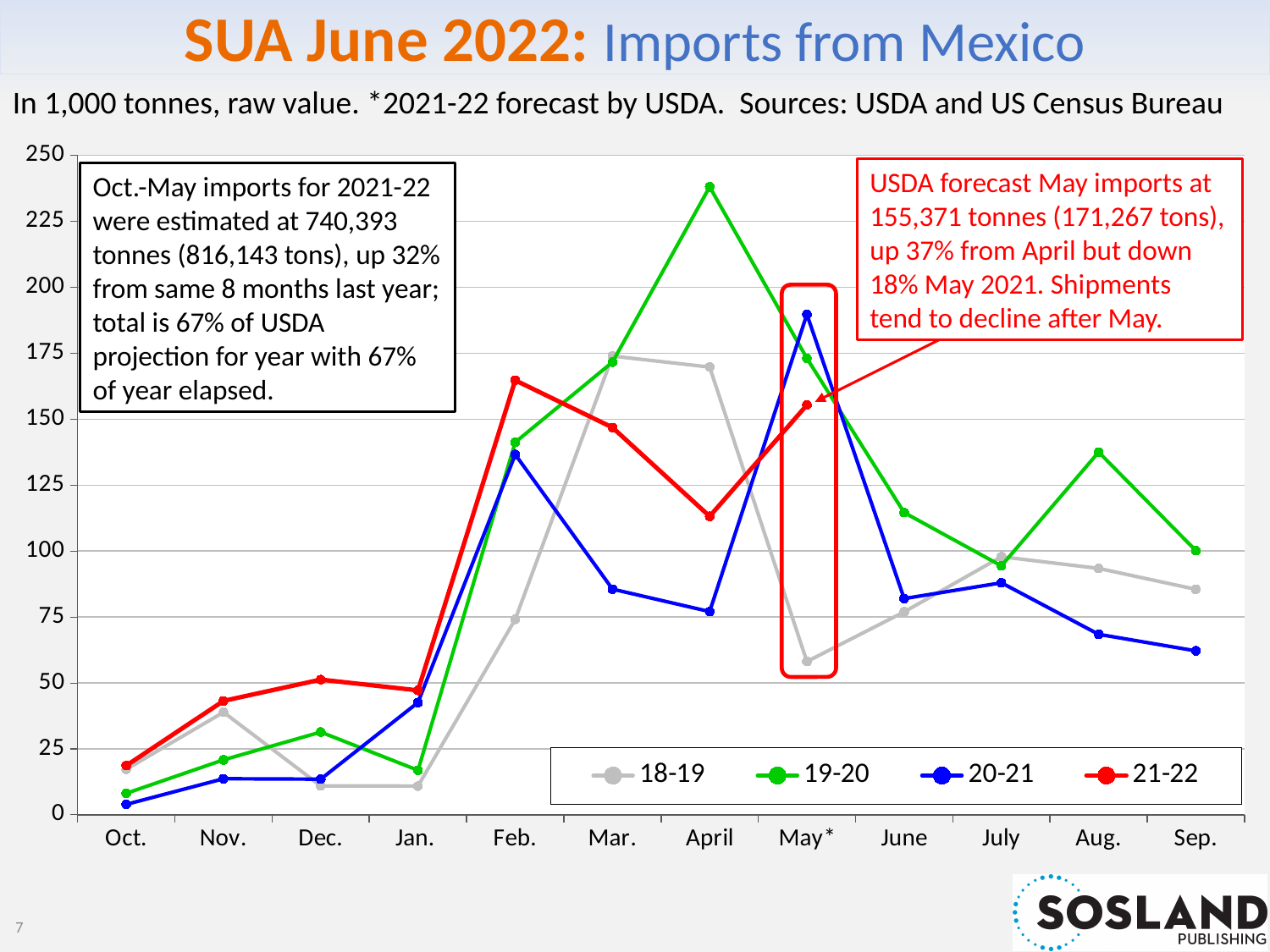
In which month does the 19-20 series reach its highest value? April How many months are shown along the x axis? 12 Is the value for 21-22 in Feb. greater or less than 150? greater Which series is drawn in red? 21-22 How many series does the legend list? 4 Is the value for 19-20 in April greater or less than 225? greater Which is larger in Aug., the 19-20 value or the 18-19 value? 19-20 Which series has the highest value in May*? 20-21 What kind of chart is shown on the slide? line chart Which series has the lowest value in May*? 18-19 Is the value for 18-19 in May* greater or less than 75? less Does the 21-22 series rise or fall from Feb. to April? fall